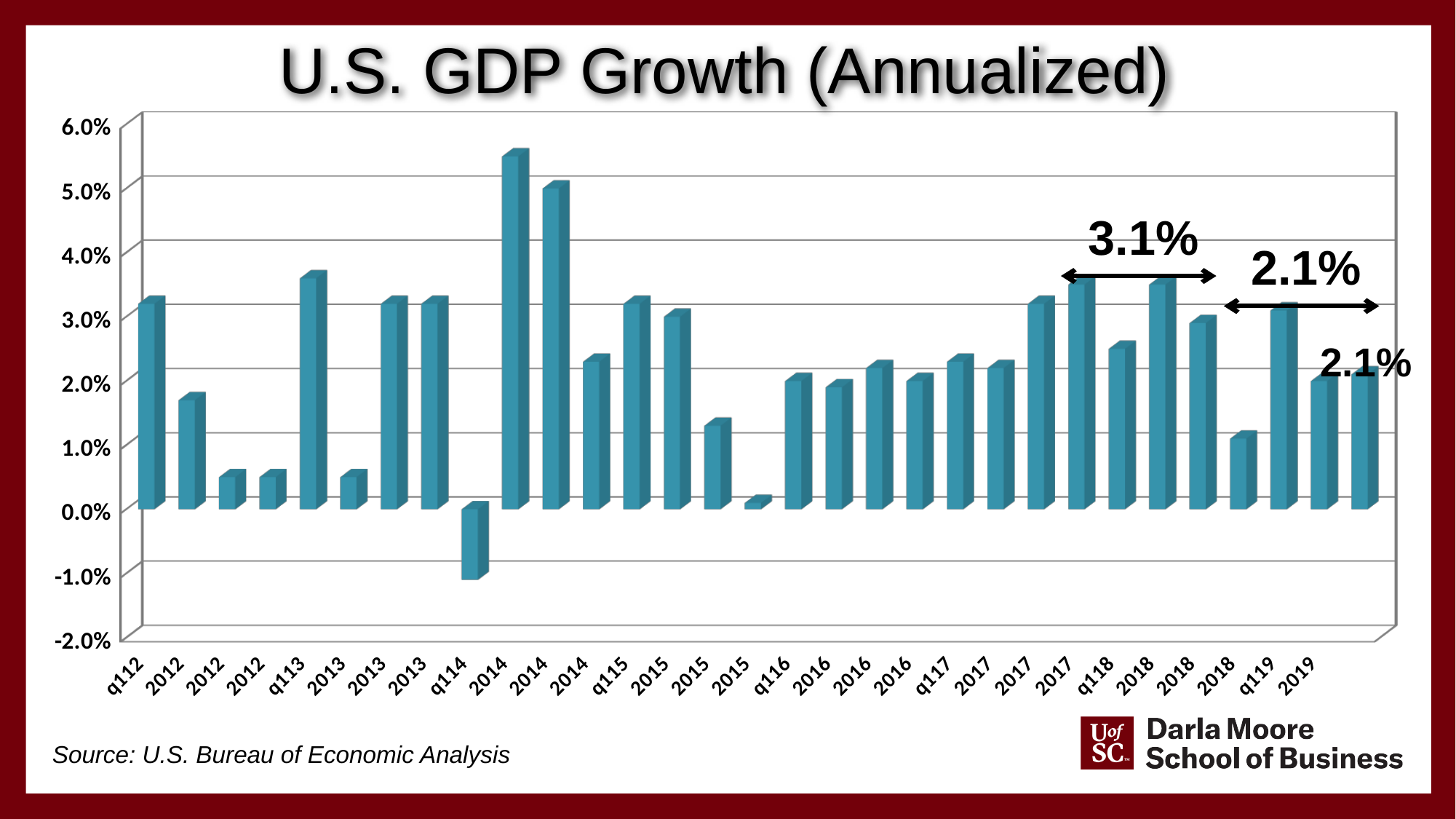
Is the value for q114 greater or less than 0.0%? less What value is annotated above the span of bars from 2017 to 2018? 3.1% Which is larger, the value for q116 or the value for q119? q119 Which is larger, the value for q113 or the value for q114? q113 What is the title of the chart? U.S. GDP Growth (Annualized) What value is annotated above the span of bars from 2018 to 2019? 2.1% Is the tallest bar in the chart greater or less than 5.0%? greater What source is cited for the chart data? U.S. Bureau of Economic Analysis Which labeled quarter has the lowest GDP growth value? q114 Is the value for q113 greater or less than 3.0%? greater What kind of chart is shown on the slide? bar chart